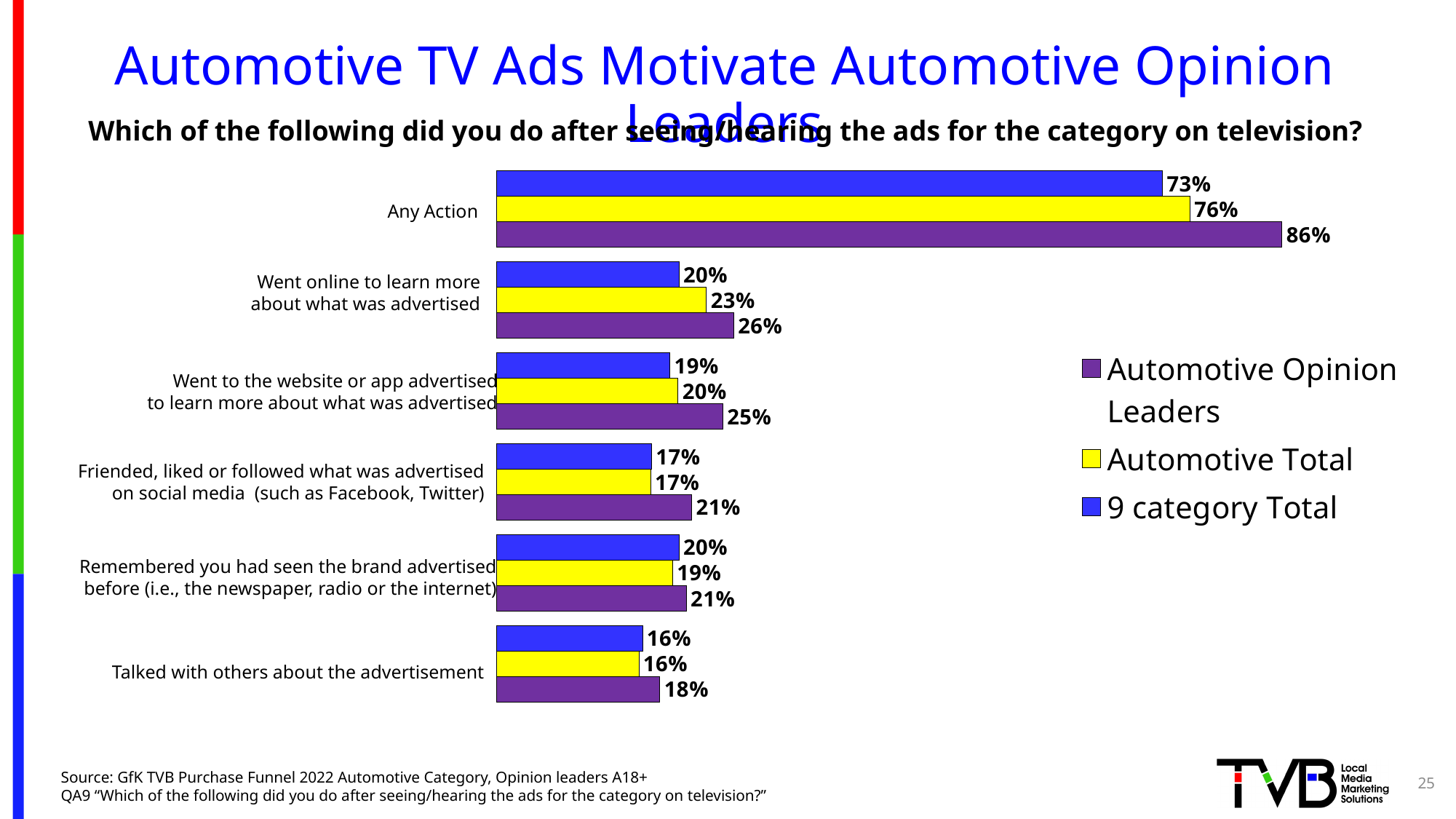
How many series does the legend list? 3 What kind of chart is shown on the slide? Bar chart How many categories are shown on the chart? 6 What is the value for 9 category Total for 'Talked with others about the advertisement'? 16% What is the value for Automotive Total for 'Went online to learn more about what was advertised'? 23% For 'Went to the website or app advertised to learn more about what was advertised', which is larger: Automotive Opinion Leaders or Automotive Total? Automotive Opinion Leaders What is the value for Automotive Opinion Leaders for 'Friended, liked or followed what was advertised on social media'? 21% What is the value for Automotive Opinion Leaders for 'Any Action'? 86% What colour represents the Automotive Total series? Yellow Which category has the lowest value for Automotive Total? Talked with others about the advertisement What is the difference between the Automotive Opinion Leaders and 9 category Total values for 'Any Action'? 13% Which category has the highest value for Automotive Opinion Leaders? Any Action